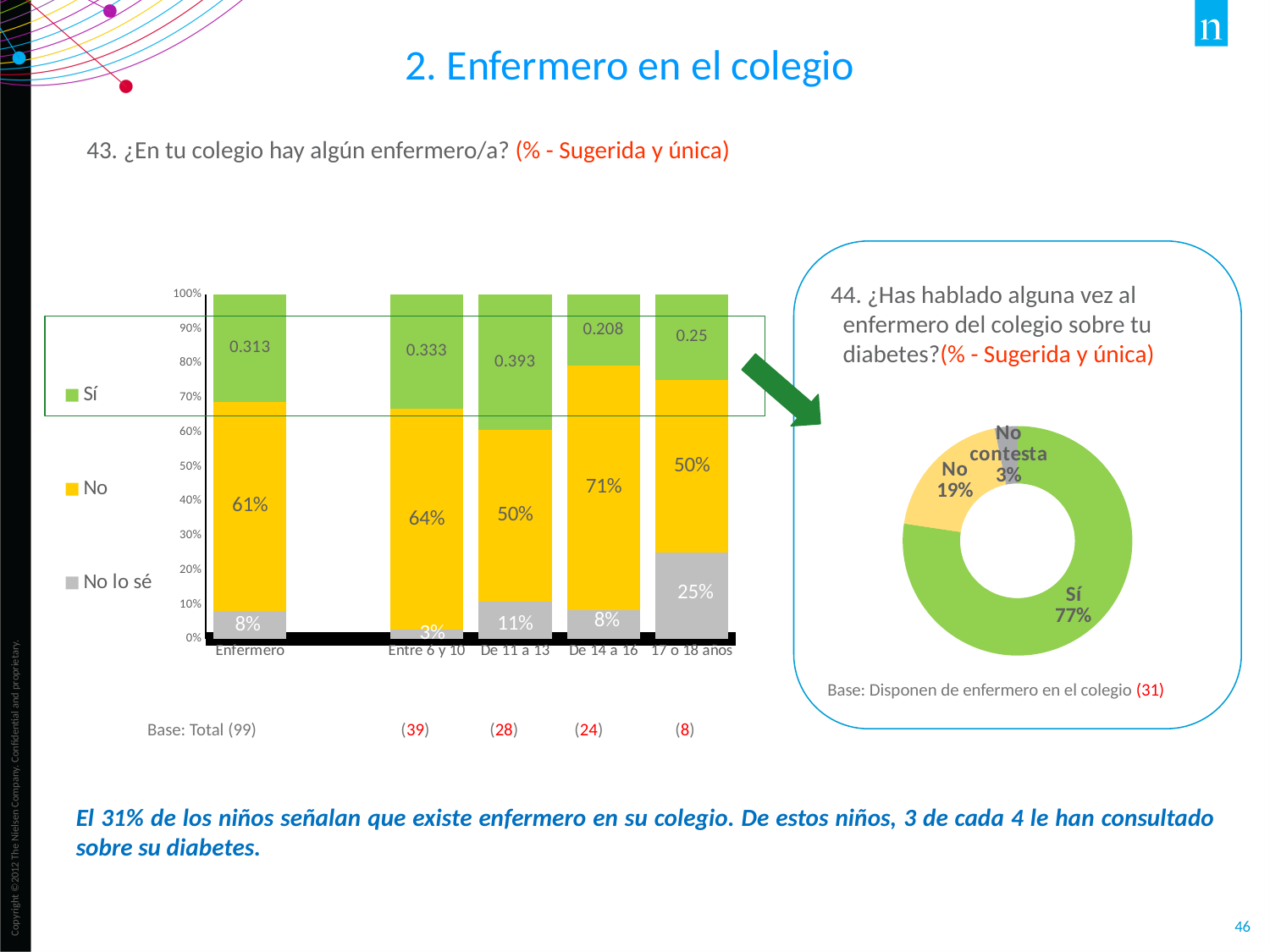
In the donut chart for question 44, what share of respondents answered 'Sí'? 77% In the stacked bar chart for question 43, what is the 'No' value for the 'De 14 a 16' group? 71% In the donut chart for question 44, which answer has the smallest share? No contesta In the stacked bar chart for question 43, how many series does the legend list? 3 In the donut chart for question 44, what is the difference between the 'Sí' and 'No' shares? 58 percentage points In the stacked bar chart for question 43, what is the 'No' value for the 'Enfermero' (total) bar? 61% In the stacked bar chart for question 43, which group has the lowest 'No lo sé' value? Entre 6 y 10 In the stacked bar chart for question 43, what is the 'No lo sé' value for the '17 o 18 años' group? 25% In the stacked bar chart for question 43, how many bars (groups) are plotted? 5 In the stacked bar chart for question 43, what is the difference between the 'No' values for 'De 14 a 16' and 'De 11 a 13'? 21 percentage points In the stacked bar chart for question 43, what label is printed on the 'Sí' segment for the 'De 11 a 13' group? 0.393 In the stacked bar chart for question 43, which group has the highest 'No lo sé' value? 17 o 18 años